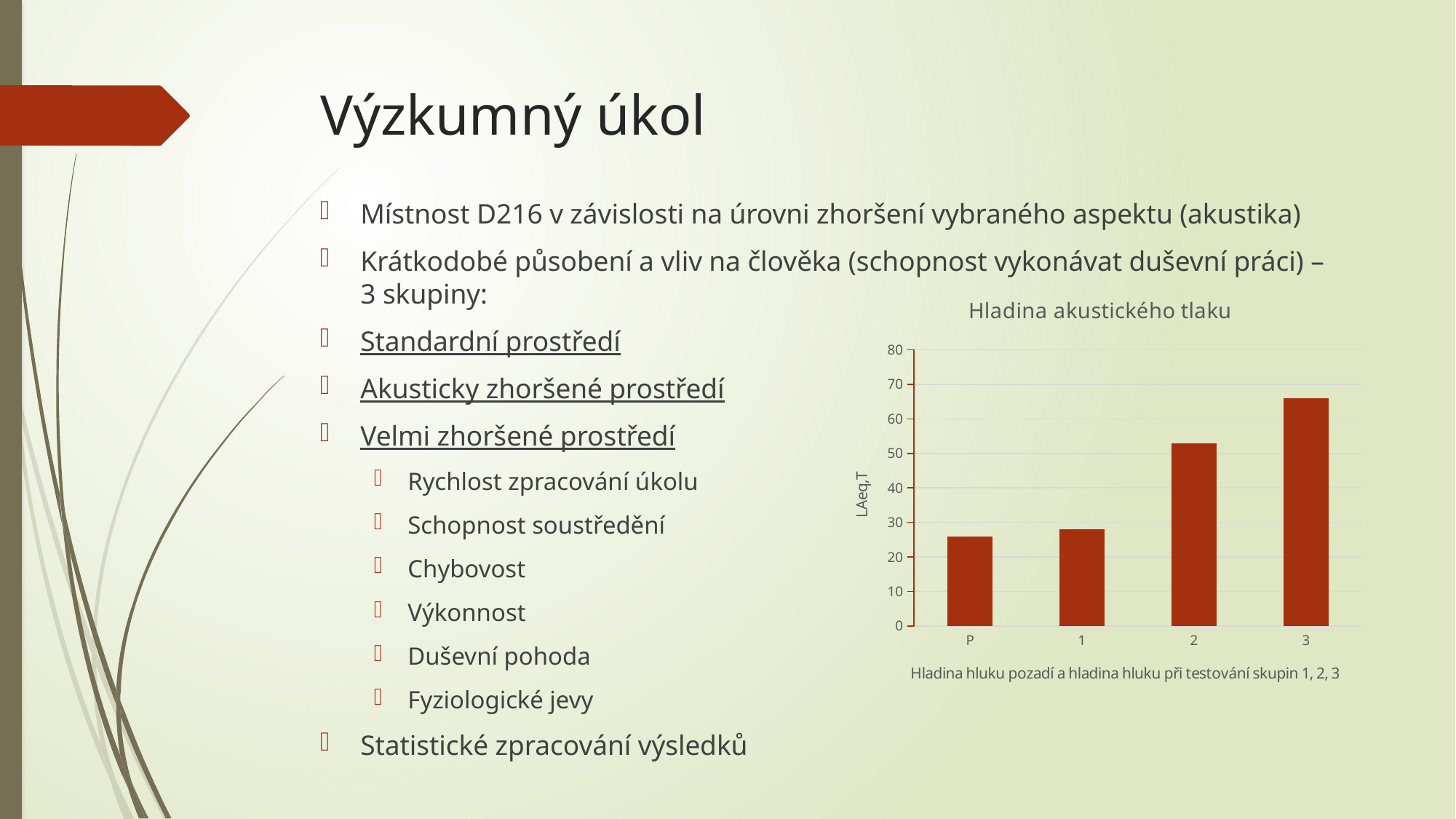
What kind of chart is shown on the slide? bar chart Is the value for category P greater or less than 30? less Which is larger, the value for category 2 or the value for category 3? 3 How many categories are shown on the x axis of the chart? 4 Is the value for category 1 greater or less than 40? less What is the label on the vertical axis of the chart? LAeq,T Do the values rise or fall from left to right along the x axis? rise Is the value for category 2 greater or less than 50? greater What is the title of the chart? Hladina akustického tlaku Which is larger, the value for category 1 or the value for category 2? 2 Which category has the highest bar in the chart? 3